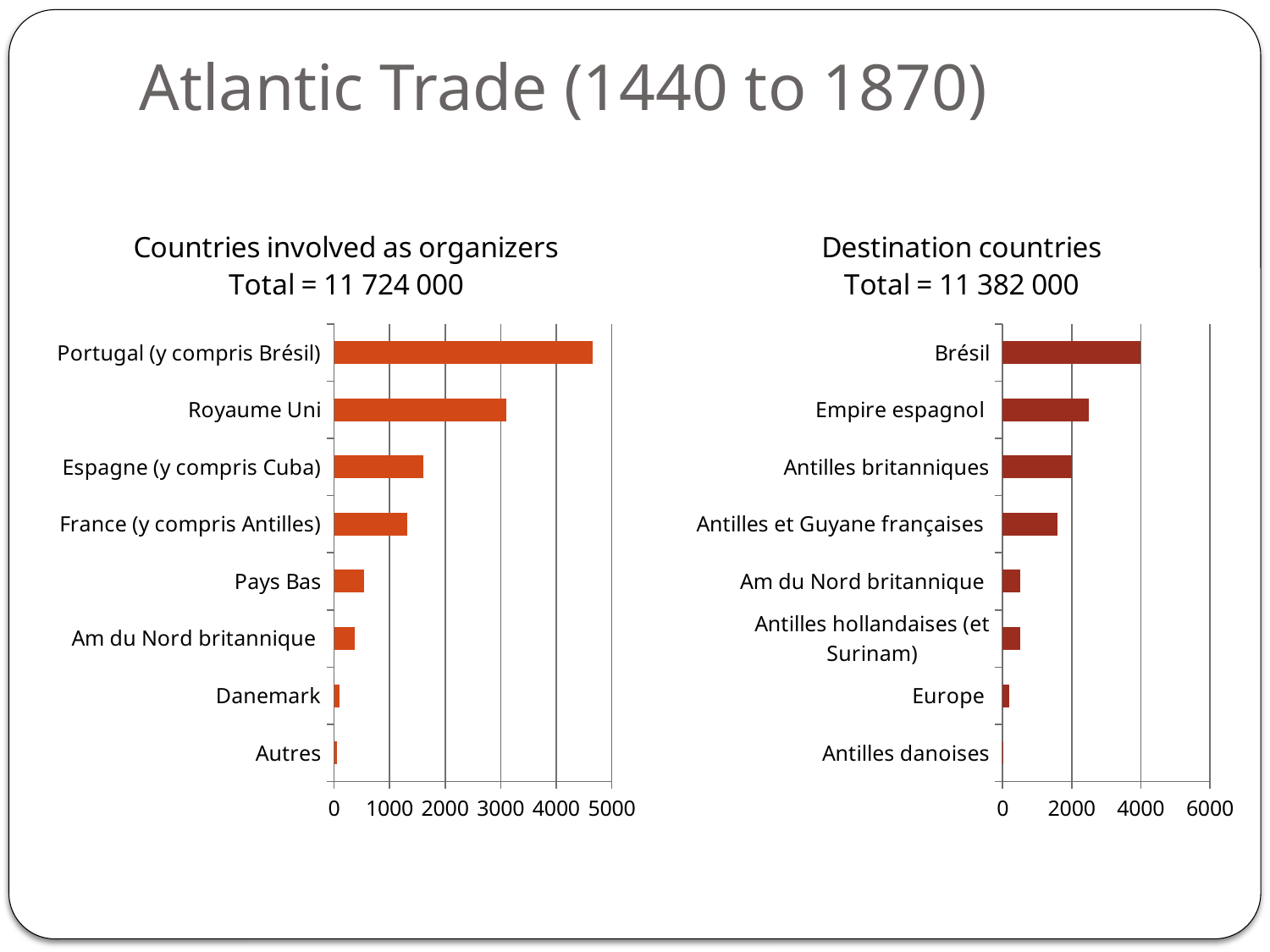
In the 'Destination countries' chart, how many categories are shown? 8 In the 'Countries involved as organizers' chart, which is larger, Espagne (y compris Cuba) or France (y compris Antilles)? Espagne (y compris Cuba) In the 'Destination countries' chart, is the value for Empire espagnol greater or less than 2000? greater In the 'Countries involved as organizers' chart, which category has the lowest value? Autres What kind of chart is the 'Countries involved as organizers' chart? bar chart In the 'Destination countries' chart, which is larger, Antilles britanniques or Antilles et Guyane françaises? Antilles britanniques In the 'Countries involved as organizers' chart, which category has the highest value? Portugal (y compris Brésil) In the 'Countries involved as organizers' chart, is the value for Royaume Uni greater or less than 3000? greater What total is stated in the title of the 'Destination countries' chart? 11 382 000 In the 'Countries involved as organizers' chart, how many categories are shown? 8 In the 'Destination countries' chart, which category has the lowest value? Antilles danoises In the 'Destination countries' chart, which category has the highest value? Brésil